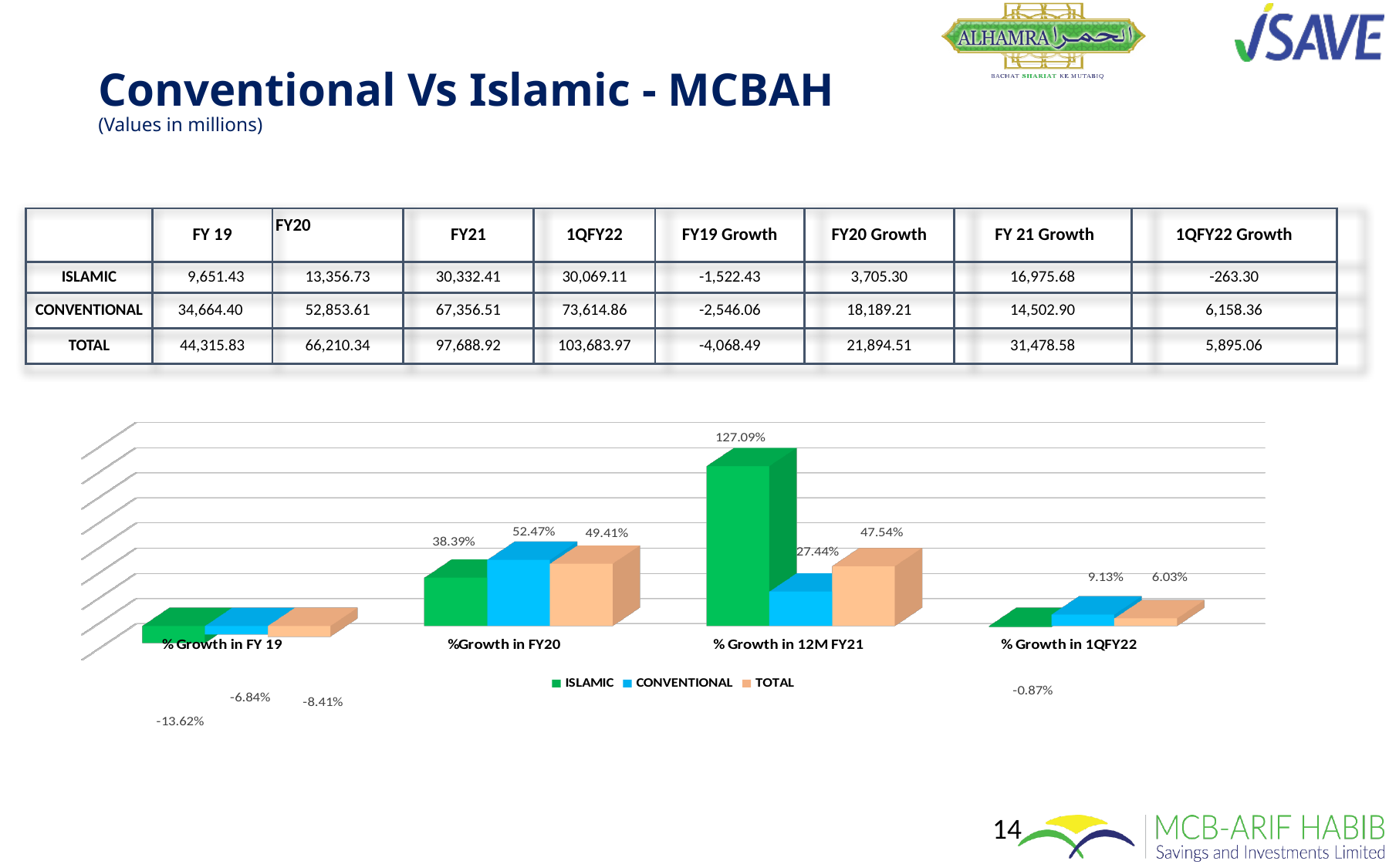
What is the ISLAMIC value for % Growth in 1QFY22? -0.87% Which is larger for % Growth in 12M FY21: the ISLAMIC value or the CONVENTIONAL value? ISLAMIC How many growth-period categories are shown on the chart's x axis? 4 What is the ISLAMIC value for % Growth in 12M FY21? 127.09% What is the CONVENTIONAL value for %Growth in FY20? 52.47% In which category is the ISLAMIC series at its lowest value? % Growth in FY 19 What is the TOTAL value for % Growth in FY 19? -8.41% What kind of chart is shown on the slide? Bar chart In which category does the ISLAMIC series reach its highest value? % Growth in 12M FY21 How many series does the chart legend list? 3 What is the difference between the CONVENTIONAL and ISLAMIC values for %Growth in FY20? 14.08% Which series is shown in green in the chart legend? ISLAMIC